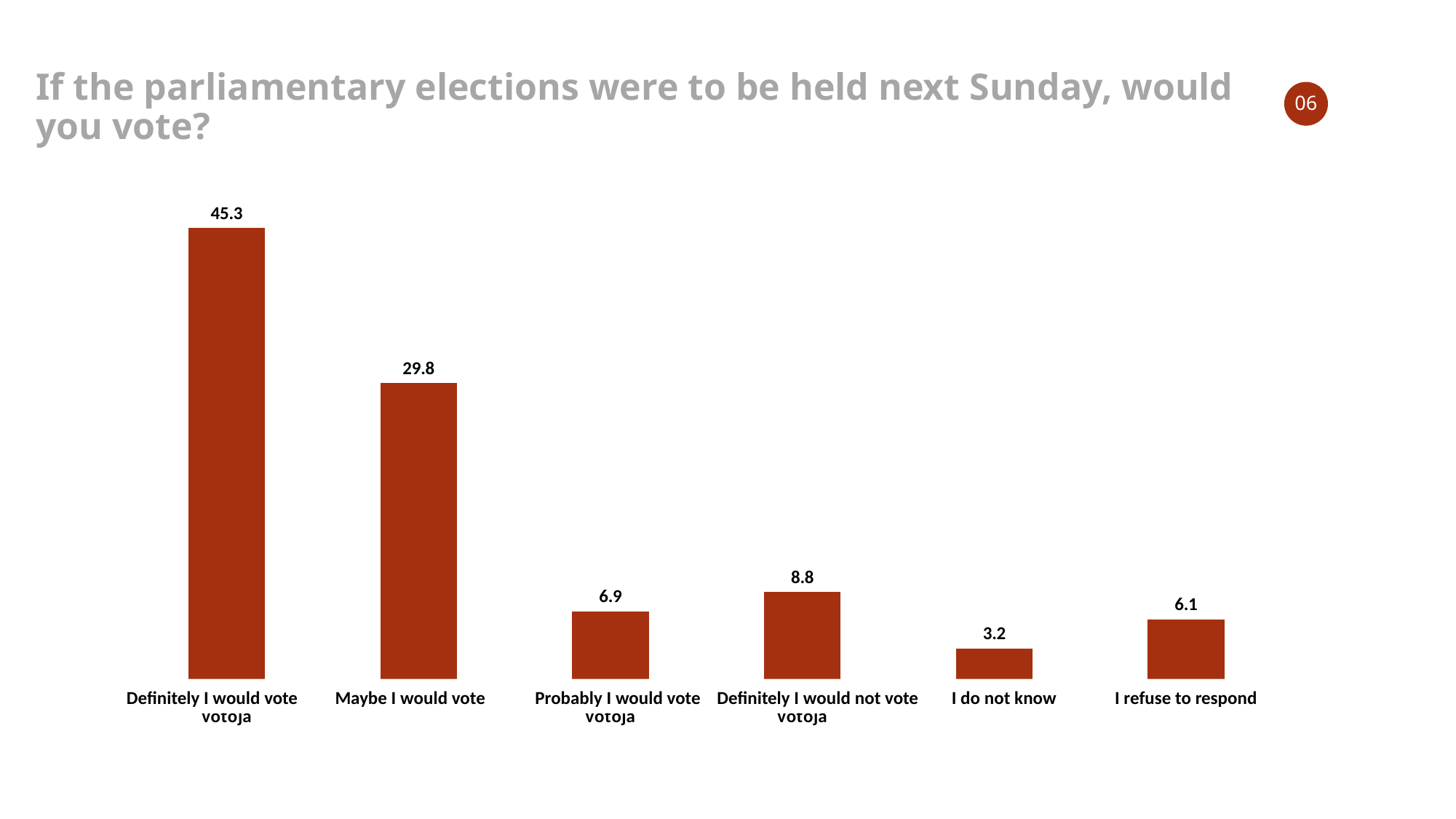
Which is larger, "Probably I would vote" or "Definitely I would not vote"? Definitely I would not vote What is the difference between "Definitely I would vote" and "Maybe I would vote"? 15.5 How many categories are shown in the chart? 6 What is the value for "Definitely I would vote"? 45.3 What kind of chart is shown on the slide? Bar chart What is the value for "Maybe I would vote"? 29.8 What is the value for "I do not know"? 3.2 What is the title of the chart? If the parliamentary elections were to be held next Sunday, would you vote? Which category has the lowest value? I do not know What is the difference between "Definitely I would not vote" and "Probably I would vote"? 1.9 What is the value for "I refuse to respond"? 6.1 Which category has the highest value? Definitely I would vote